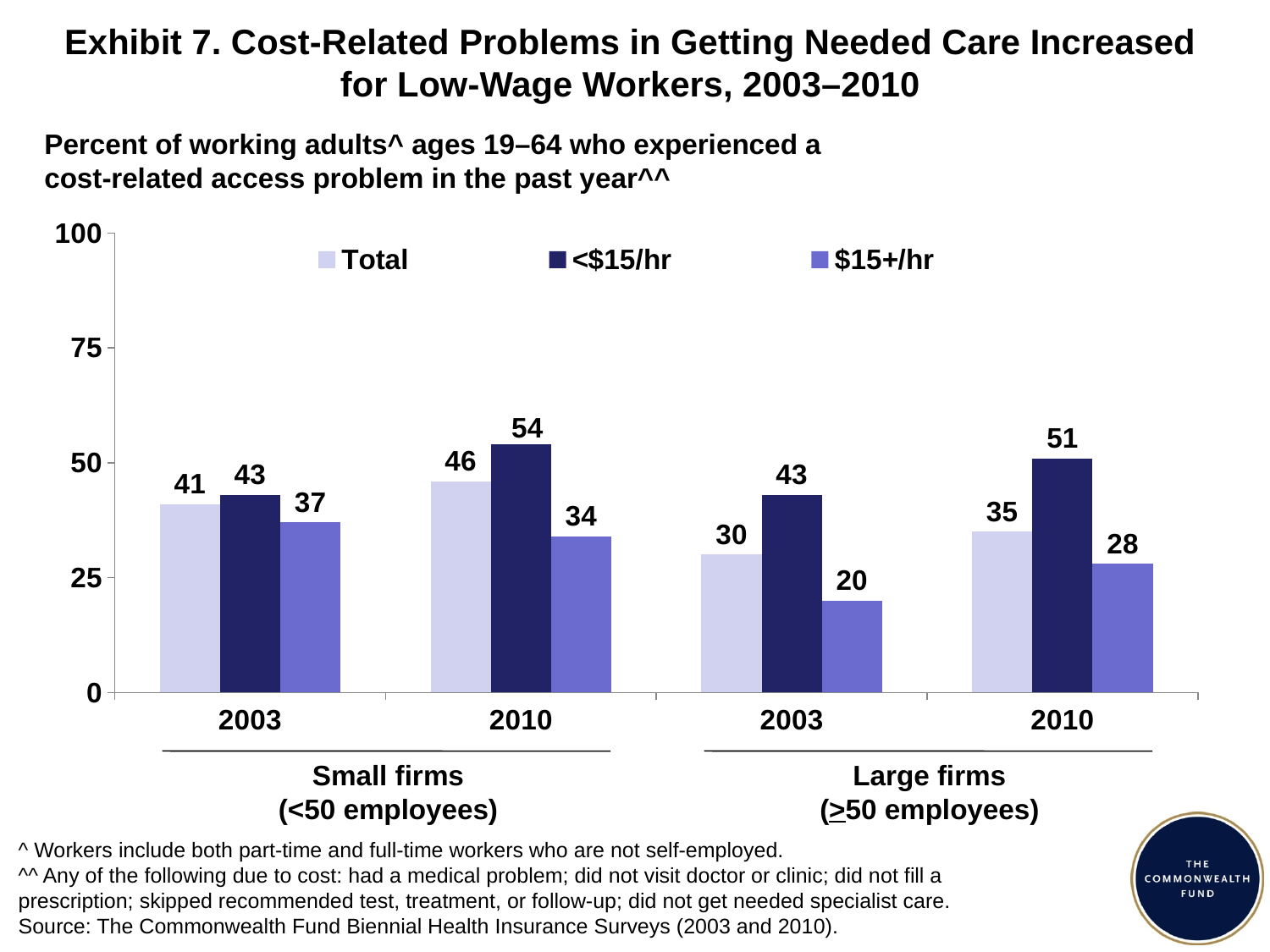
Which series is shown in the darkest colour? <$15/hr Which is larger: the Total value for small firms in 2003 or the Total value for large firms in 2003? Small firms in 2003 What is the difference between the <$15/hr and $15+/hr values for large firms in 2010? 23 What is the value for $15+/hr workers at large firms in 2003? 20 What kind of chart is shown on the slide? Bar chart What is the Total value for large firms in 2010? 35 What is the value for <$15/hr workers at small firms in 2010? 54 Did the Total value for large firms rise or fall from 2003 to 2010? Rise Which group and year has the highest value on the chart? <$15/hr, small firms, 2010 By how much did the <$15/hr value for small firms change from 2003 to 2010? 11 Which group and year has the lowest value on the chart? $15+/hr, large firms, 2003 How many series does the legend list? 3